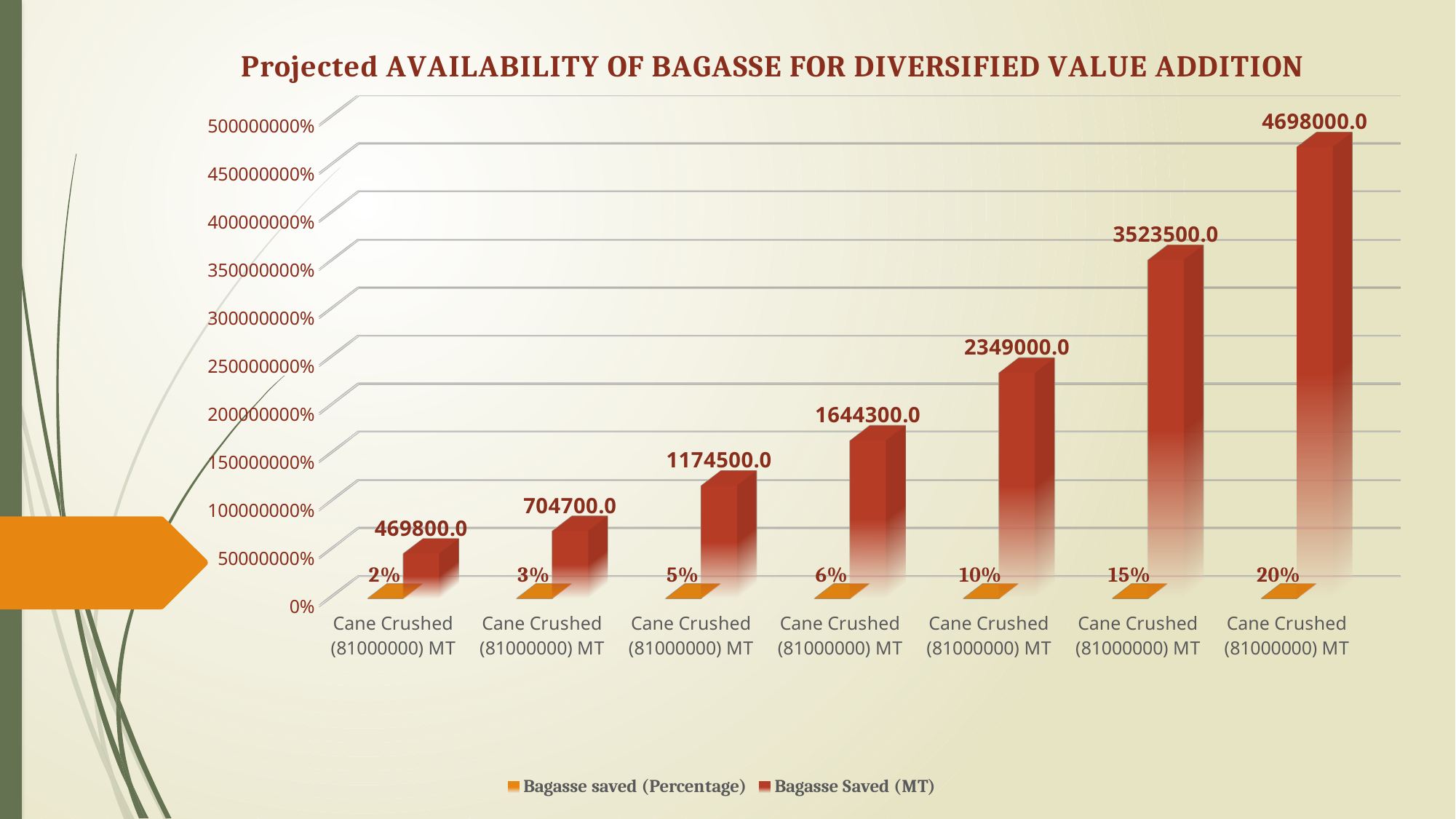
How many Bagasse Saved (MT) bars are plotted on the chart? 7 Which percentage level has the highest Bagasse Saved (MT) value? 20% What is the Bagasse Saved (MT) value for the bar labelled 2%? 469800.0 What kind of chart is shown on the slide? bar chart What is the difference in Bagasse Saved (MT) between the 20% bar and the 2% bar? 4228200.0 Which has a larger Bagasse Saved (MT) value, the 15% bar or the 6% bar? 15% What is the Bagasse Saved (MT) value for the bar labelled 20%? 4698000.0 What is the difference in Bagasse Saved (MT) between the 6% bar and the 5% bar? 469800.0 Which percentage level has the lowest Bagasse Saved (MT) value? 2% How many series does the legend list? 2 Do the Bagasse Saved (MT) values rise or fall from left to right along the x axis? rise What is the Bagasse Saved (MT) value for the bar labelled 10%? 2349000.0